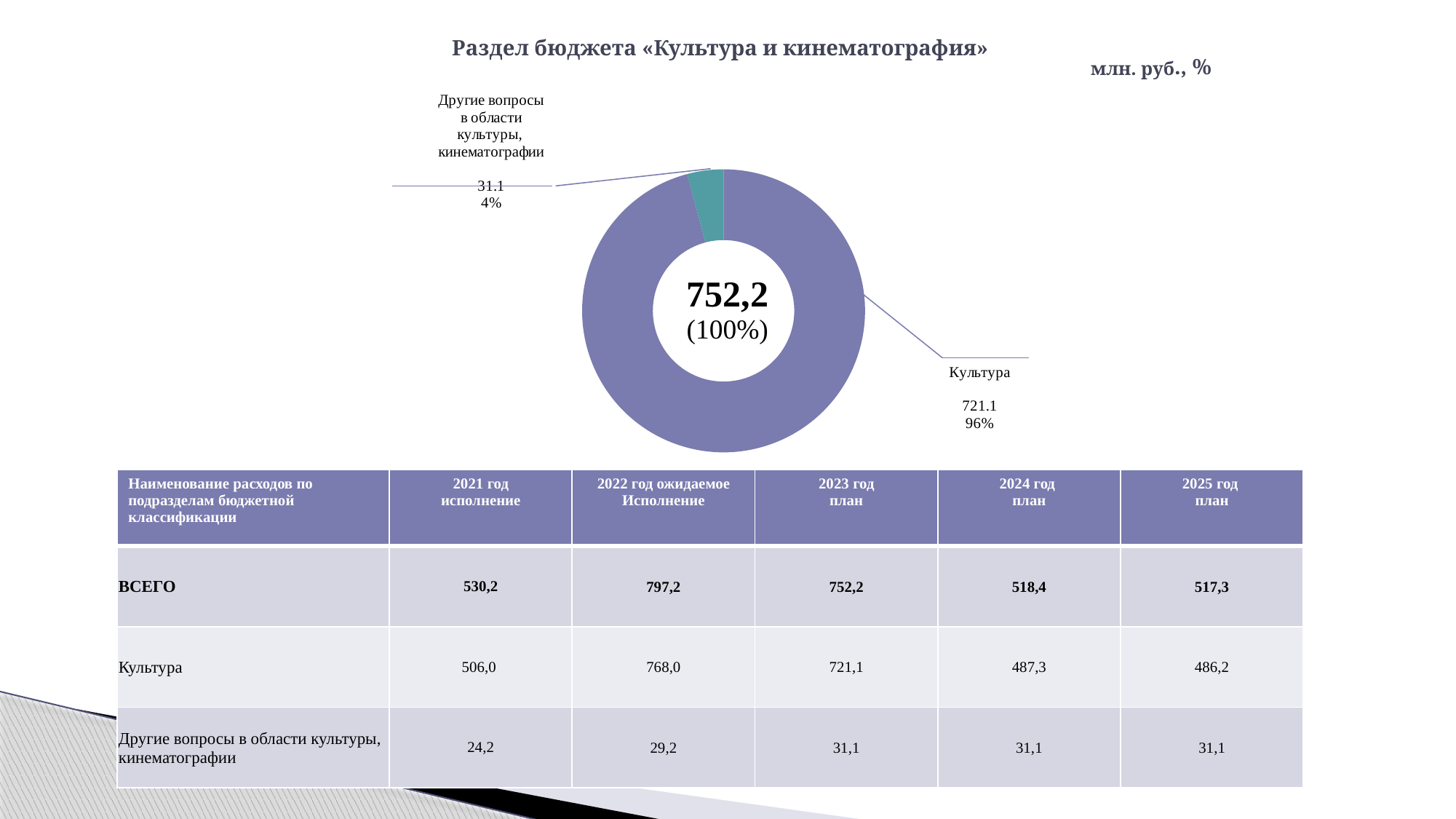
What is the difference between the values for Культура and Другие вопросы в области культуры, кинематографии in the donut chart? 690.0 What kind of chart is shown on the slide? Donut (pie) chart What share of the donut chart does Культура represent? 96% What share of the donut chart does Другие вопросы в области культуры, кинематографии represent? 4% What is the value shown for Другие вопросы в области культуры, кинематографии in the donut chart? 31.1 Which slice of the donut chart is the smallest? Другие вопросы в области культуры, кинематографии Which is larger in the donut chart: Культура or Другие вопросы в области культуры, кинематографии? Культура Which slice of the donut chart is the largest? Культура What total value is shown in the centre of the donut chart? 752,2 What is the title of the chart on the slide? Раздел бюджета «Культура и кинематография» What is the value shown for Культура in the donut chart? 721.1 How many slices does the donut chart have? 2